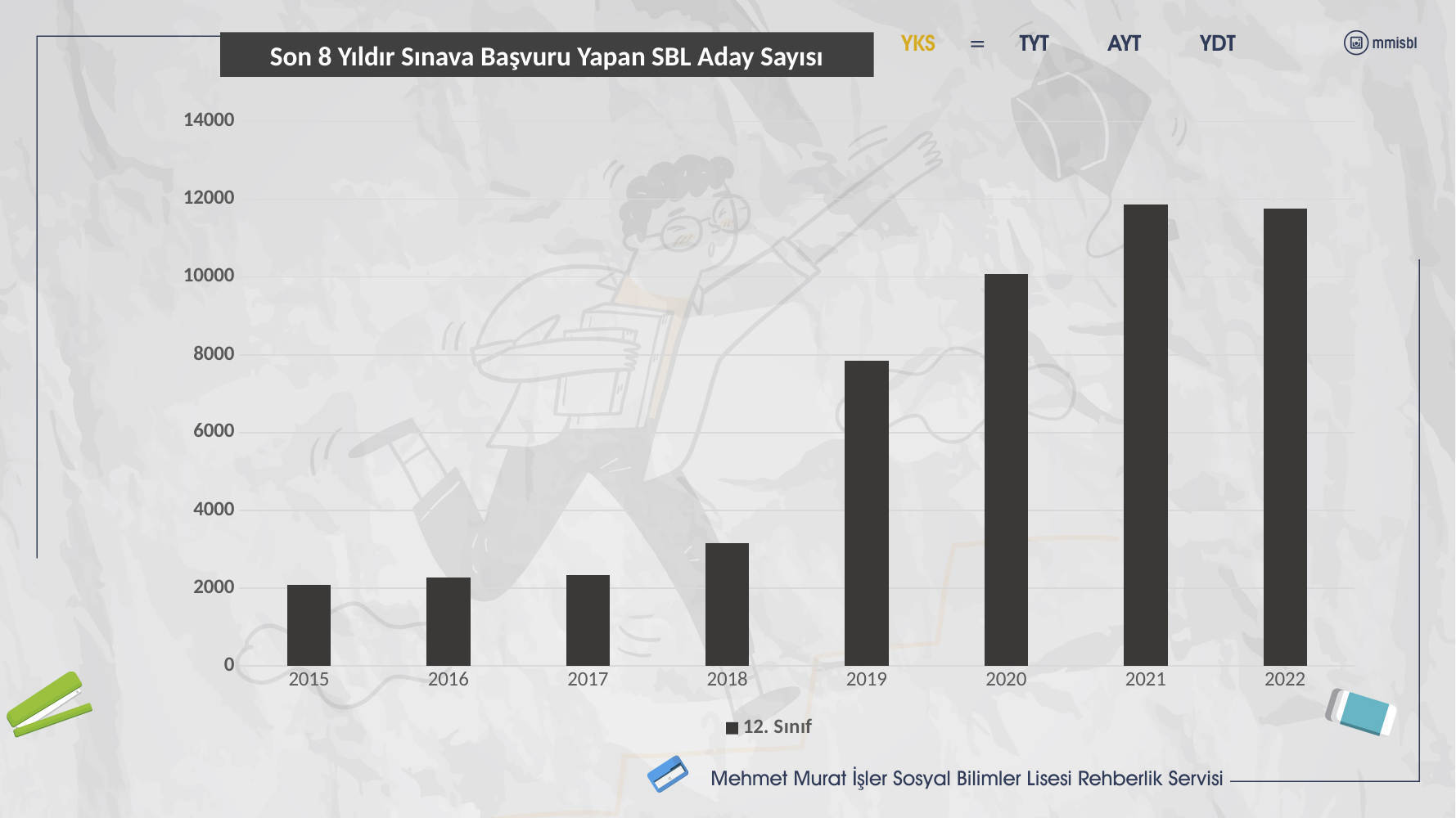
How many years are shown on the x axis of the chart? 8 Is the value for 2022 greater or less than 10000? greater Which is larger, the value for 2018 or the value for 2019? 2019 Do the values generally rise or fall from 2015 to 2022? rise Is the value for 2018 greater or less than 4000? less Which year has the lowest value in the chart? 2015 How many series does the chart's legend list? 1 What is the legend entry of the chart? 12. Sınıf What kind of chart is shown on the slide? bar chart What is the title of the chart? Son 8 Yıldır Sınava Başvuru Yapan SBL Aday Sayısı Is the value for 2019 greater or less than 8000? less